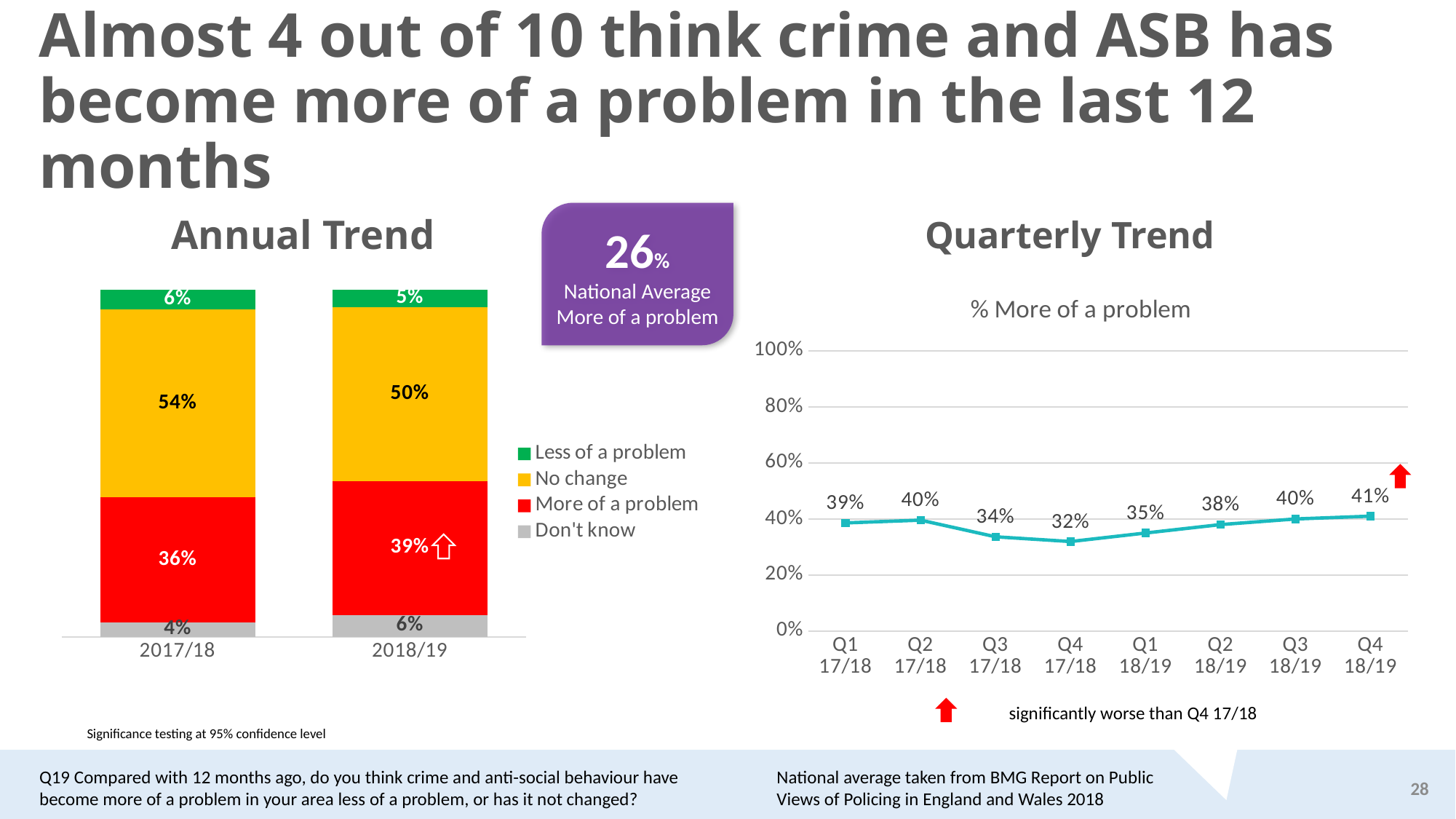
In the Quarterly Trend chart, which quarter has the lowest value? Q4 17/18 In the Quarterly Trend chart, what is the difference between Q4 18/19 and Q4 17/18? 9 percentage points In the Annual Trend chart, which year has the larger 'Don't know' share, 2017/18 or 2018/19? 2018/19 In the Annual Trend chart, what percentage said 'No change' in 2017/18? 54% What kind of chart is the Annual Trend chart? Stacked bar chart In the Quarterly Trend chart, which quarter has the highest value? Q4 18/19 In the Quarterly Trend chart, what is the value for Q4 17/18? 32% In the Annual Trend chart, what is the difference between the 'No change' values for 2017/18 and 2018/19? 4 percentage points How many series does the legend of the Annual Trend chart list? 4 In the Quarterly Trend chart, do the values rise or fall from Q4 17/18 to Q4 18/19? Rise In the Annual Trend chart, what percentage said 'More of a problem' in 2018/19? 39% How many quarters are plotted in the Quarterly Trend chart? 8